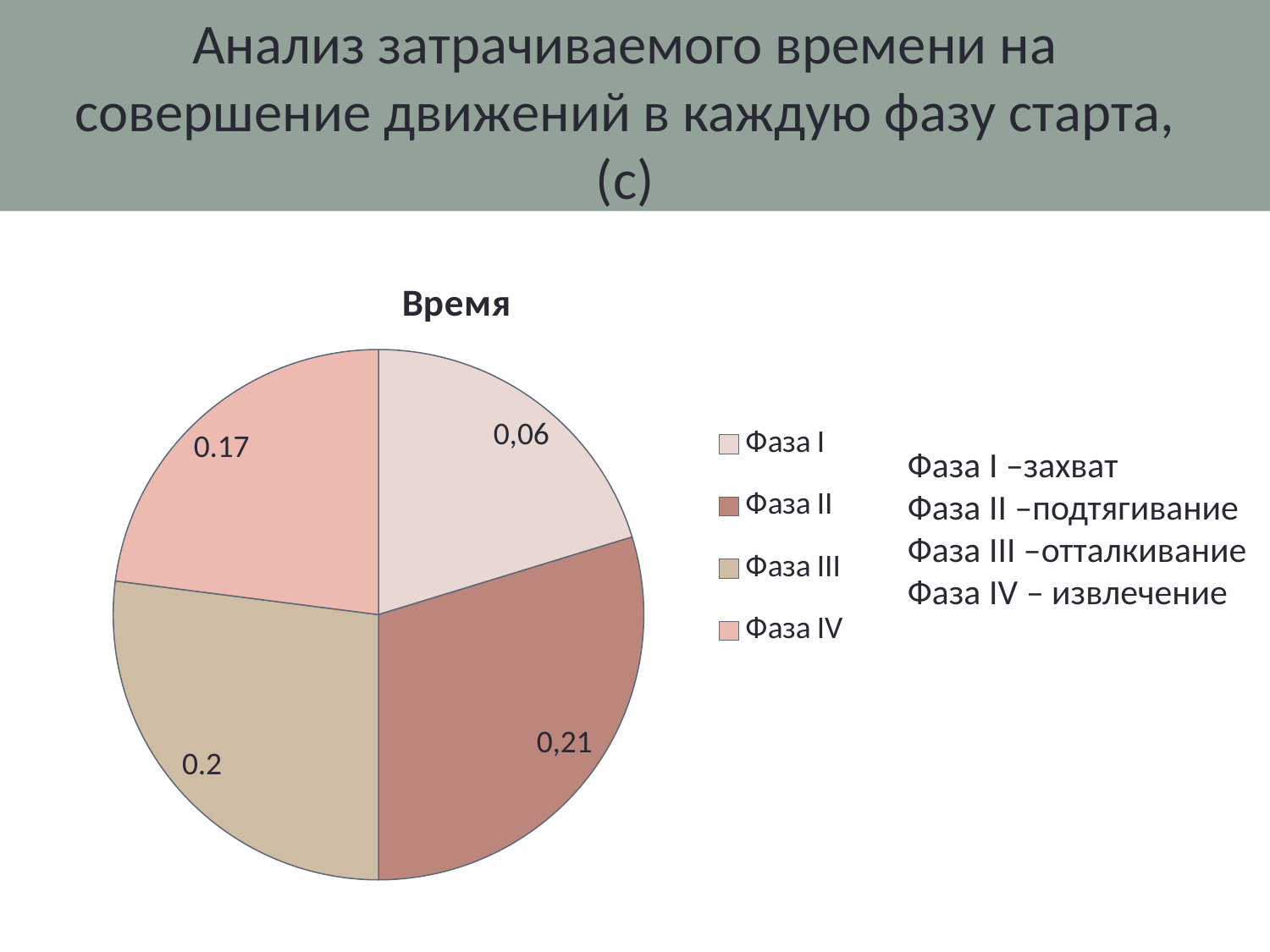
What kind of chart is shown on the slide? pie chart What value is shown for Фаза III? 0.2 What value is shown for Фаза II? 0,21 What value is shown for Фаза IV? 0.17 Which is larger, the value for Фаза IV or the value for Фаза I? Фаза IV What is the chart's title? Время What is the difference between the values for Фаза III and Фаза IV? 0.03 What value is shown for Фаза I? 0,06 How many slices does the pie chart have? 4 Which phase has the largest slice of the pie? Фаза II Which phase has the smallest slice of the pie? Фаза I What is the difference between the values for Фаза II and Фаза I? 0,15